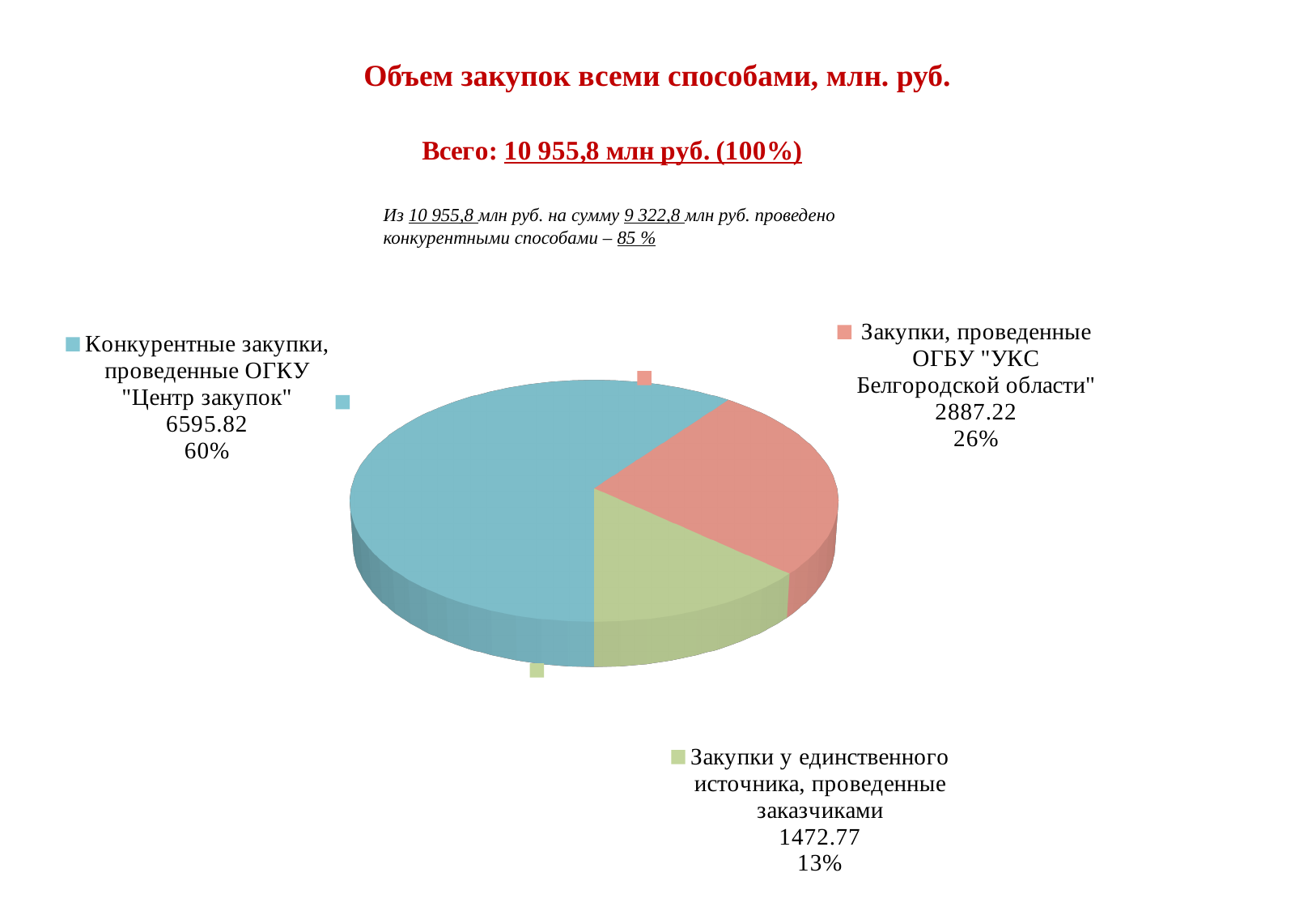
What type of chart is shown on the slide? pie chart Which category has the largest slice of the pie? Конкурентные закупки, проведенные ОГКУ "Центр закупок" What is the value for Конкурентные закупки, проведенные ОГКУ "Центр закупок"? 6595.82 What is the title of the chart on the slide? Объем закупок всеми способами, млн. руб. How many slices does the pie chart have? 3 What is the value for Закупки, проведенные ОГБУ "УКС Белгородской области"? 2887.22 What share of the pie is Закупки у единственного источника, проведенные заказчиками? 13% Which is larger: Закупки, проведенные ОГБУ "УКС Белгородской области" or Закупки у единственного источника, проведенные заказчиками? Закупки, проведенные ОГБУ "УКС Белгородской области" What is the difference between the values for Конкурентные закупки, проведенные ОГКУ "Центр закупок" and Закупки, проведенные ОГБУ "УКС Белгородской области"? 3708.60 What share of the pie is Конкурентные закупки, проведенные ОГКУ "Центр закупок"? 60% What is the value for Закупки у единственного источника, проведенные заказчиками? 1472.77 Which category has the smallest slice of the pie? Закупки у единственного источника, проведенные заказчиками